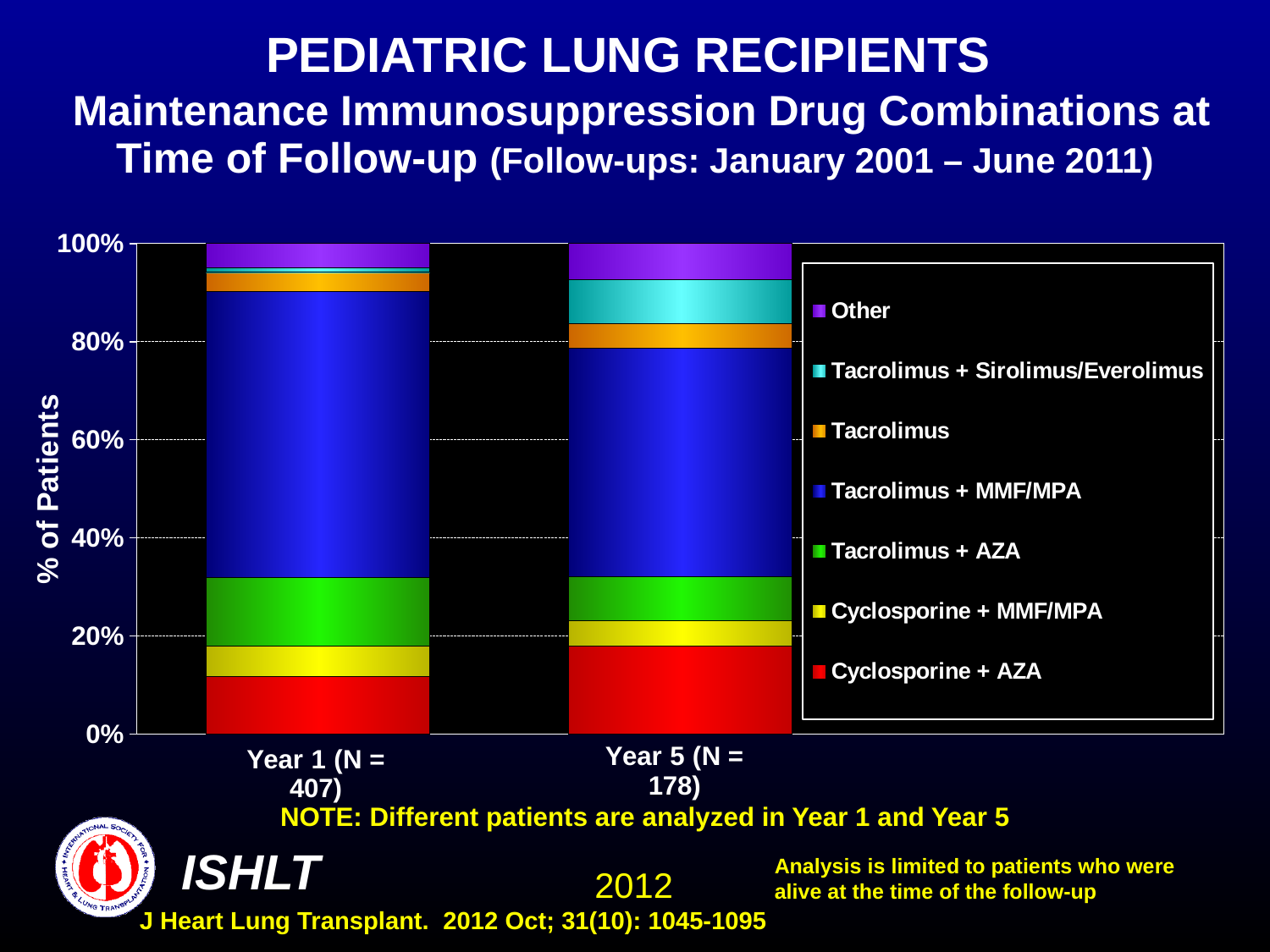
Which series is the largest segment in the Year 5 (N = 178) bar? Tacrolimus + MMF/MPA Is the Tacrolimus + MMF/MPA share in the Year 5 (N = 178) bar greater or less than 20%? greater Is the Tacrolimus + MMF/MPA share in the Year 1 (N = 407) bar greater or less than 40%? greater What is the label of the y axis? % of Patients Which bar has the larger Tacrolimus + MMF/MPA segment, Year 1 (N = 407) or Year 5 (N = 178)? Year 1 (N = 407) What are the two category labels on the x axis? Year 1 (N = 407) and Year 5 (N = 178) Which bar has the larger Tacrolimus + Sirolimus/Everolimus segment, Year 1 (N = 407) or Year 5 (N = 178)? Year 5 (N = 178) What kind of chart is shown on the slide? Stacked bar chart Is the Cyclosporine + AZA share in the Year 1 (N = 407) bar greater or less than 20%? less How many bars (categories) are plotted on the chart? 2 Which series is the largest segment in the Year 1 (N = 407) bar? Tacrolimus + MMF/MPA How many series does the legend list? 7